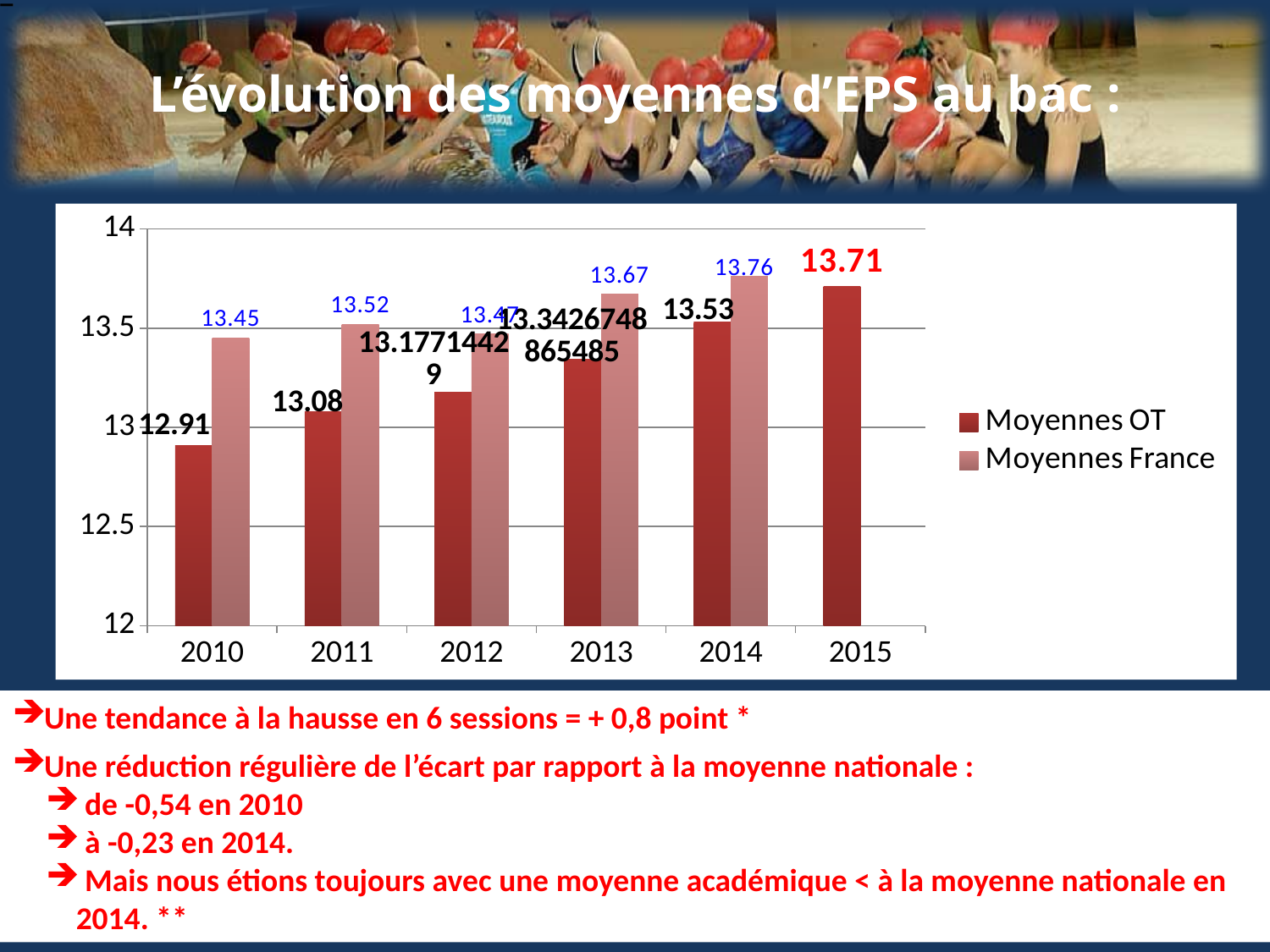
How many series does the legend list? 2 In 2014, which is larger: Moyennes OT or Moyennes France? Moyennes France What is the value of Moyennes OT for 2015? 13.71 What kind of chart is shown on the slide? bar chart What is the value of Moyennes France for 2010? 13.45 In which year is Moyennes France highest? 2014 What is the value of Moyennes France for 2014? 13.76 What is the value of Moyennes OT for 2010? 12.91 Do the Moyennes OT values rise or fall from 2010 to 2015? rise In which year is Moyennes OT lowest? 2010 What is the difference between Moyennes OT in 2014 and in 2010? 0.62 Is the value of Moyennes OT for 2013 greater or less than 13.5? less